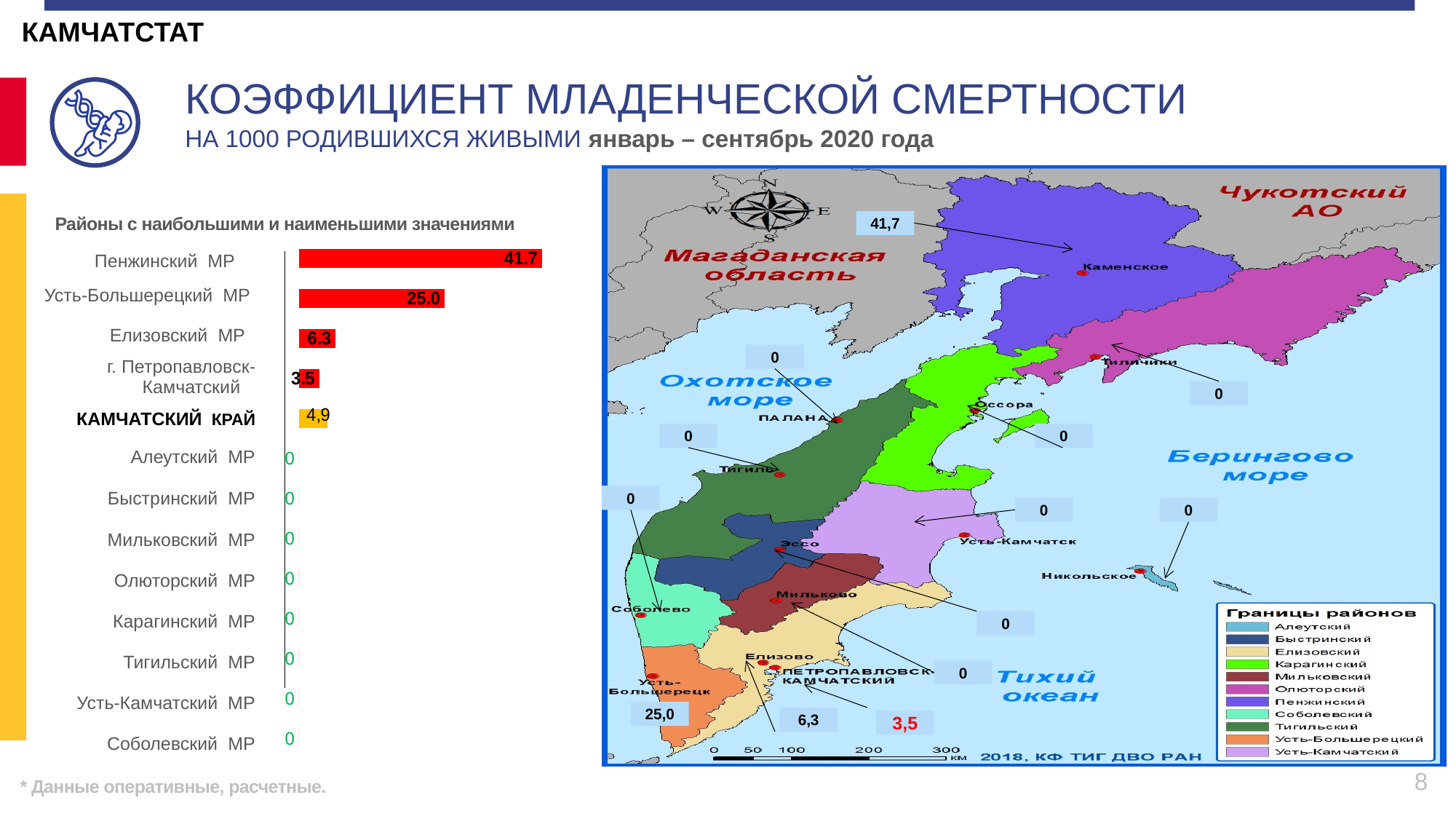
Which is larger, the value for Елизовский МР or for г. Петропавловск-Камчатский? Елизовский МР What is the infant mortality rate shown for Пенжинский МР? 41.7 What is the subtitle above the bar chart? Районы с наибольшими и наименьшими значениями What value is shown for Елизовский МР? 6.3 What kind of chart is shown on the left of the slide? Bar chart What value is shown for Усть-Большерецкий МР? 25.0 What value is shown for г. Петропавловск-Камчатский? 3.5 How many districts in the bar chart have a value of 0? 8 What value is shown for КАМЧАТСКИЙ КРАЙ? 4,9 How many categories are listed in the bar chart? 13 What is the difference between the values for Пенжинский МР and Усть-Большерецкий МР? 16.7 Which district has the highest value in the bar chart? Пенжинский МР